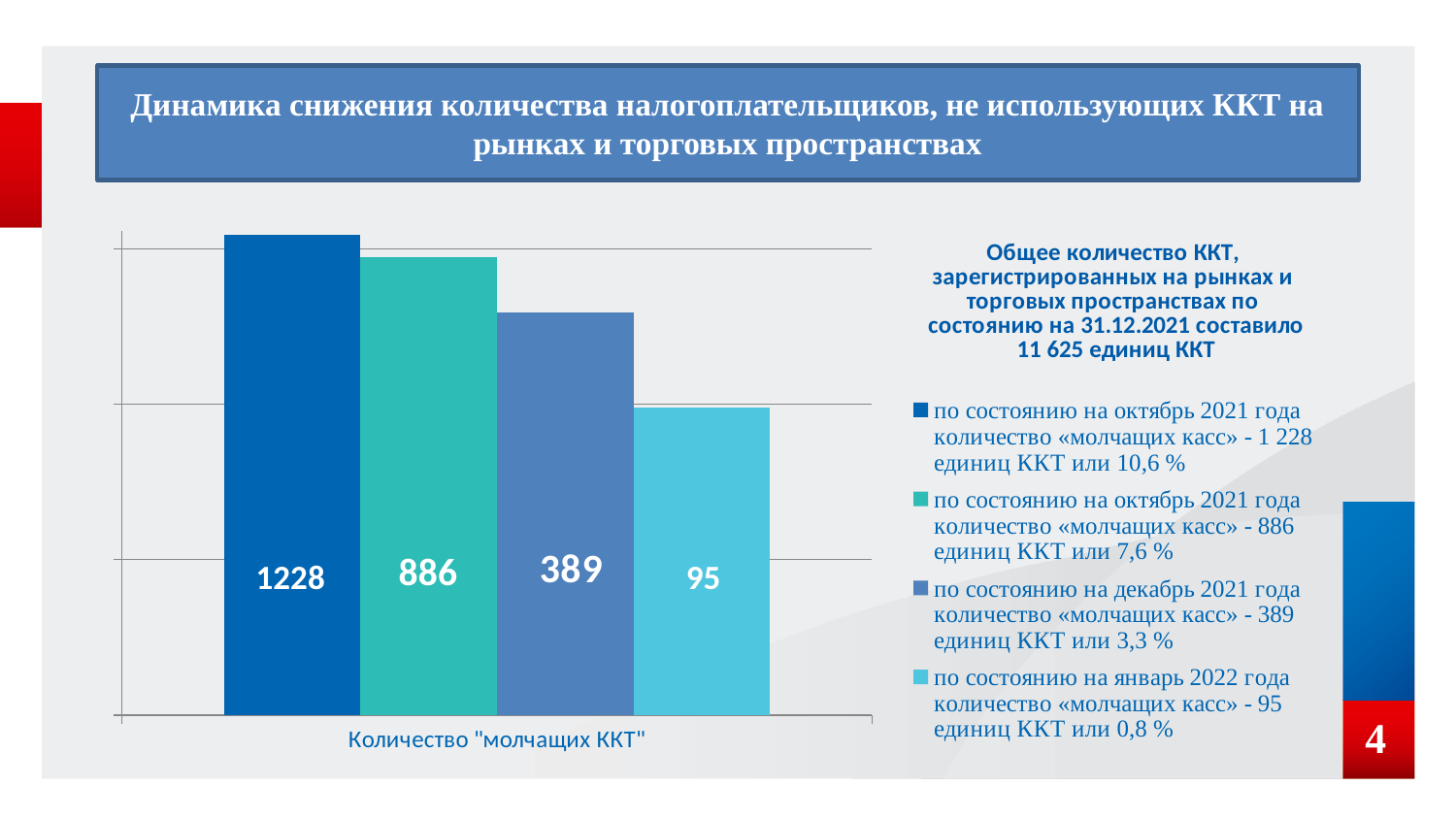
What is the value shown on the leftmost (dark blue) bar? 1228 What kind of chart is shown on the slide? bar chart What is the value of the second (teal) bar? 886 Which bar has the lowest value? the rightmost bar (январь 2022), 95 Which bar has the highest value? the leftmost bar, 1228 How many series does the legend list? 4 Do the bar values rise or fall from left to right? fall What is the value of the bar for декабрь 2021 года? 389 What is the value shown on the rightmost (light blue) bar, for январь 2022? 95 What is the difference between the first bar (1228) and the second bar (886)? 342 How many bars are plotted in the chart? 4 Which is larger: the second bar or the third bar? the second bar (886)